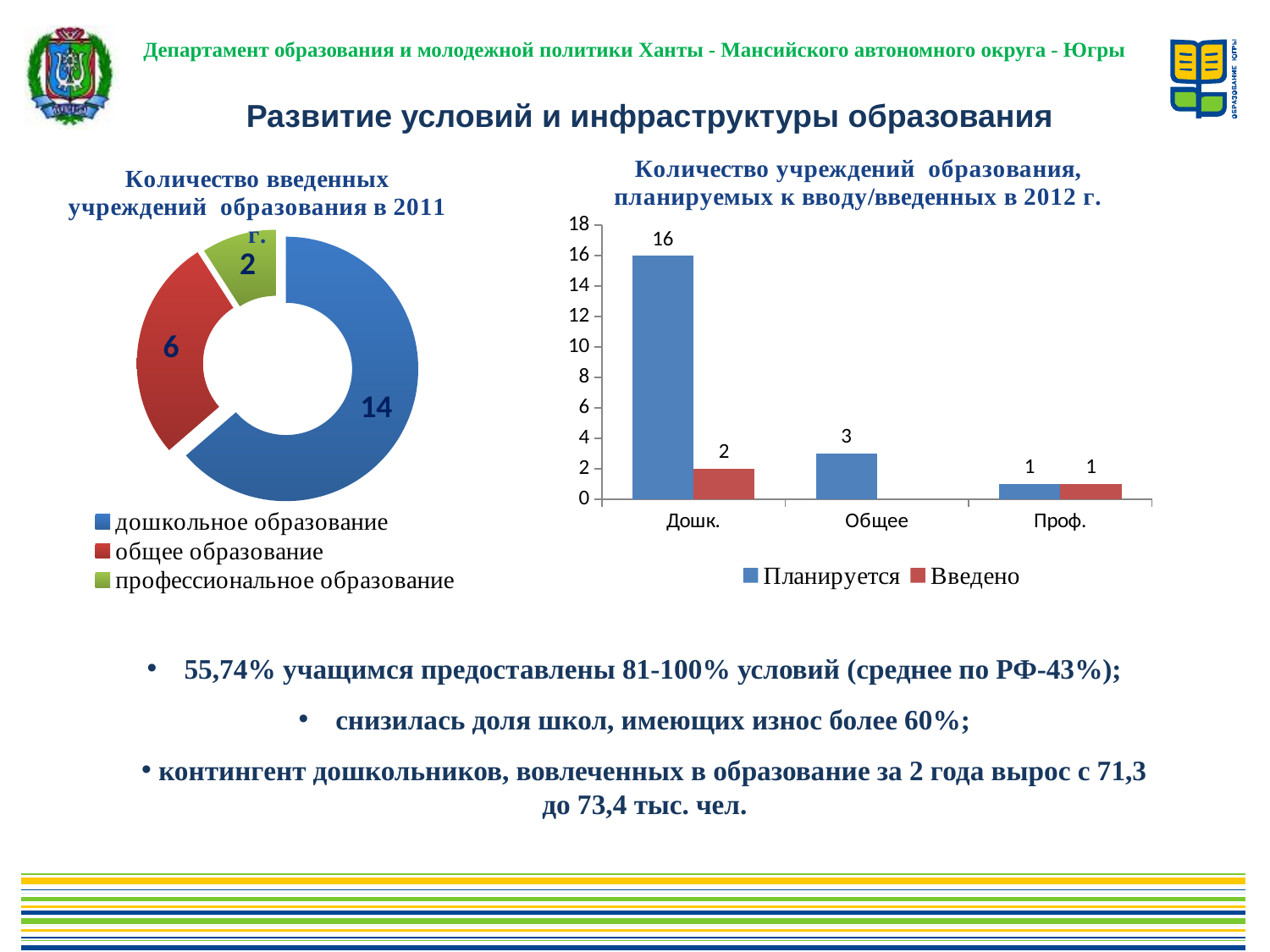
In the right bar chart, which category has the highest Планируется value? Дошк. In the left doughnut chart, what is the value for общее образование? 6 In the right bar chart, what is the Введено value for Дошк.? 2 What type of chart is the chart on the right side of the slide? bar chart In the left doughnut chart, what is the difference between дошкольное образование and общее образование? 8 In the left doughnut chart, how many categories are shown? 3 In the left doughnut chart, which category has the smallest value? профессиональное образование In the right bar chart, how many series does the legend list? 2 In the left doughnut chart (Количество введенных учреждений образования в 2011 г.), what is the value for дошкольное образование? 14 In the right bar chart, what is the Планируется value for Общее? 3 In the right bar chart (Количество учреждений образования, планируемых к вводу/введенных в 2012 г.), what is the Планируется value for Дошк.? 16 In the right bar chart, what is the difference between the Планируется and Введено values for Дошк.? 14